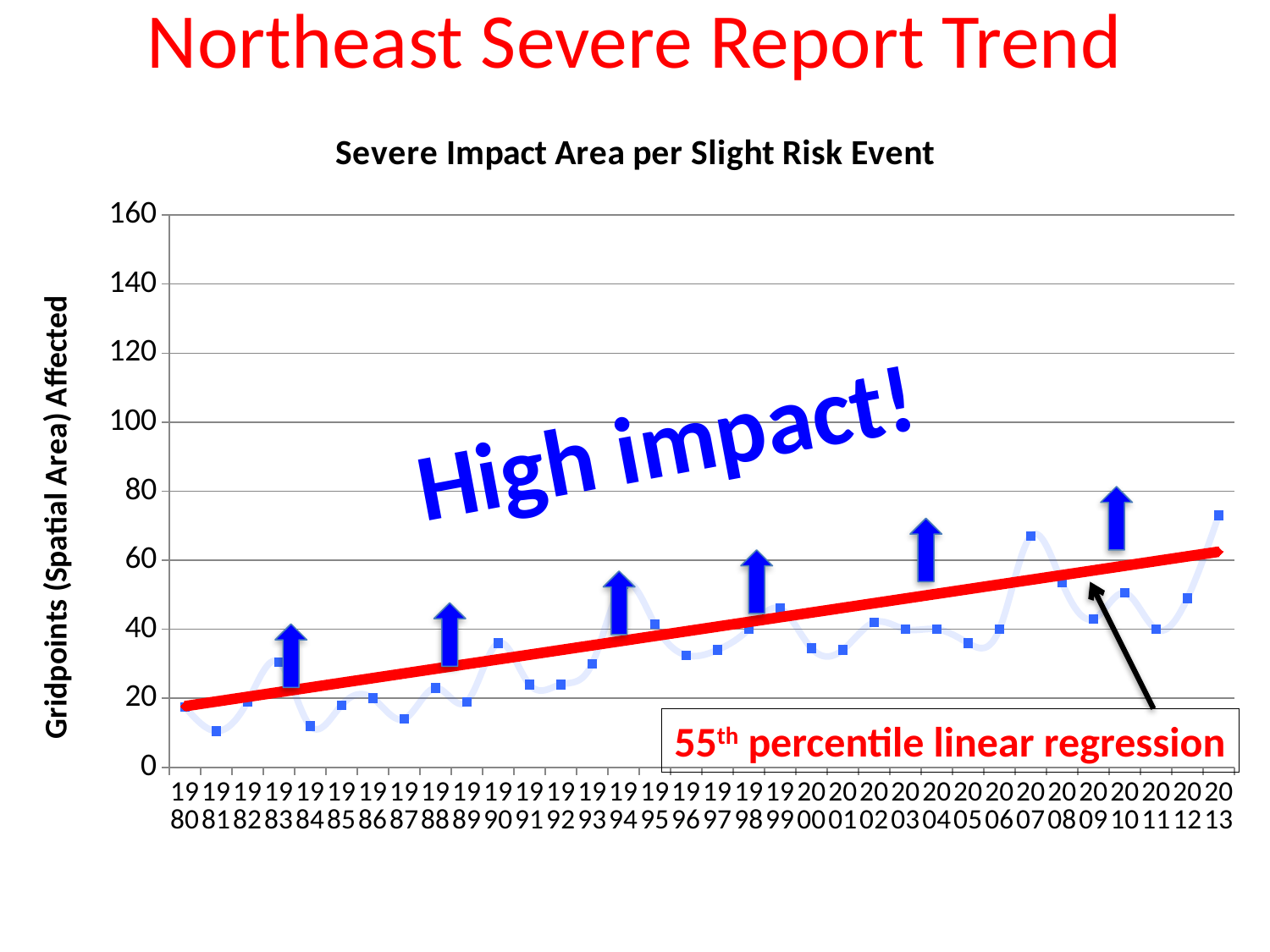
What is the label of the vertical axis? Gridpoints (Spatial Area) Affected Which year has the larger value, 1990 or 2007? 2007 Is the value for 2013 greater or less than 60? greater Which year has the larger value, 1980 or 2013? 2013 What kind of chart is shown on the slide? Line chart Is the value for 1990 greater or less than 40? less What is the title of the chart? Severe Impact Area per Slight Risk Event Is the value for 1981 greater or less than 20? less How many years are plotted along the x axis? 34 Which year has the highest plotted value? 2013 Do the plotted values generally rise or fall from 1980 to 2013? Rise